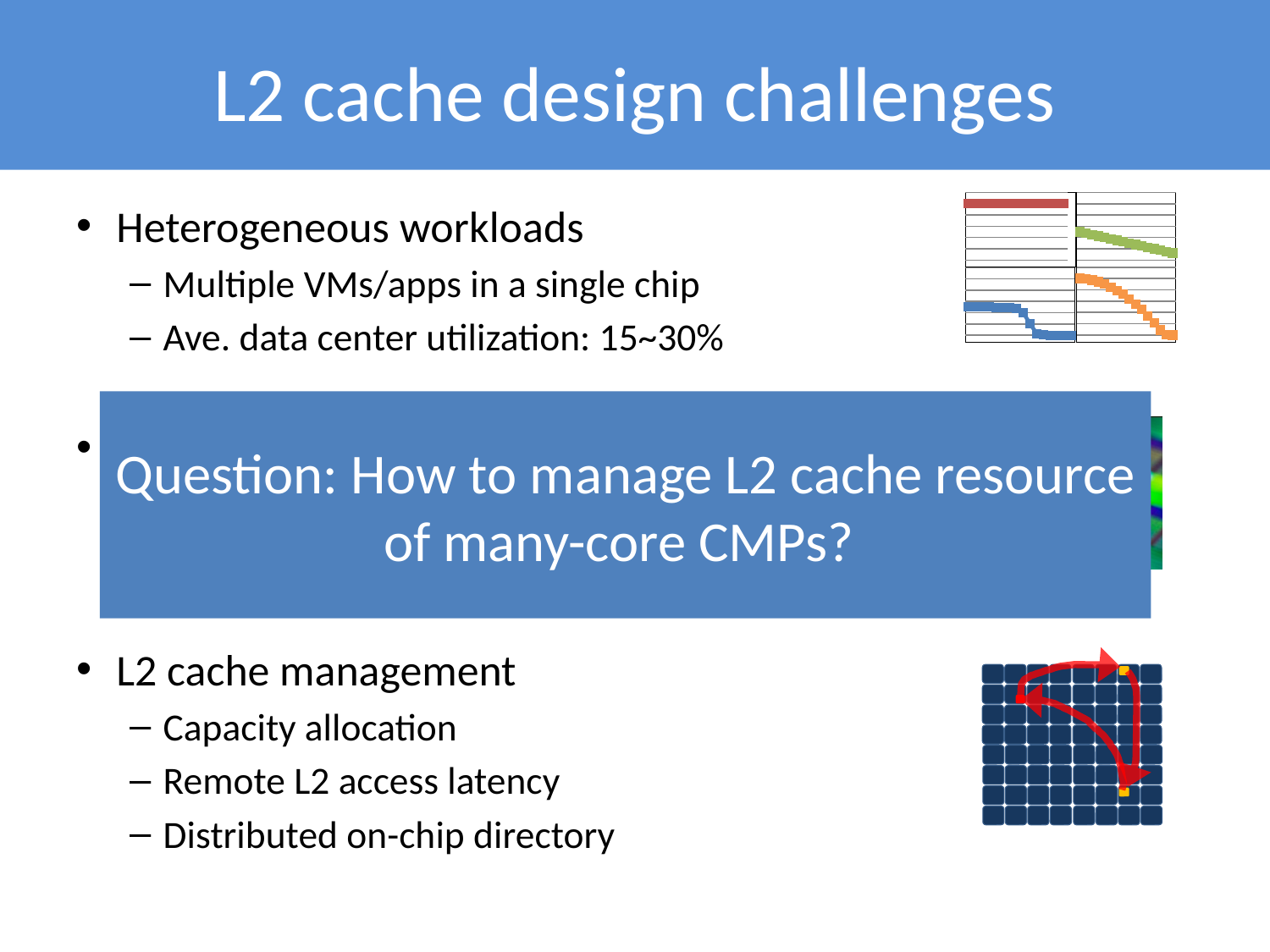
In the small chart panels at the top right, which colour line stays flat across the panel? red In the small chart image at the top right of the slide, how many separate chart panels are shown? 4 What kind of chart are the small panels at the top right of the slide? line chart In the small chart panels at the top right, does the blue line rise or fall from left to right? fall In the small chart panels at the top right, does the green line rise or fall from left to right? fall In the small chart panels at the top right, does the orange line rise or fall from left to right? fall